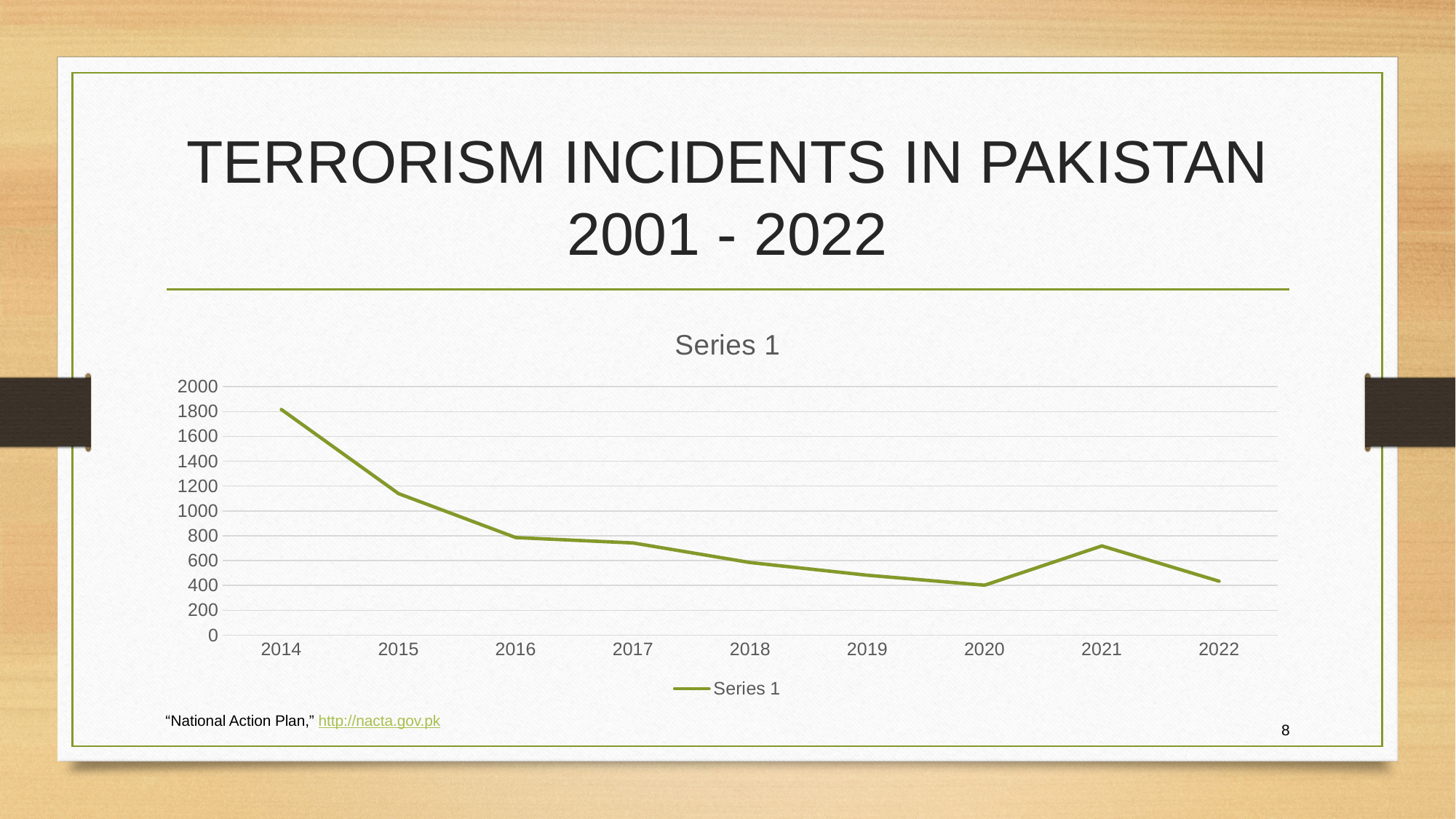
Is the value for 2020 greater or less than 600? less How many years are plotted along the x axis of the chart? 9 How many series does the chart's legend list? 1 Which is larger, the value for 2020 or the value for 2021? 2021 Is the value for 2014 greater or less than 1600? greater Do the values rise or fall from 2014 to 2020? fall Which year has the highest value in the chart? 2014 What is the title shown above the chart? Series 1 Is the value for 2015 greater or less than 1000? greater What kind of chart is shown on the slide? line chart